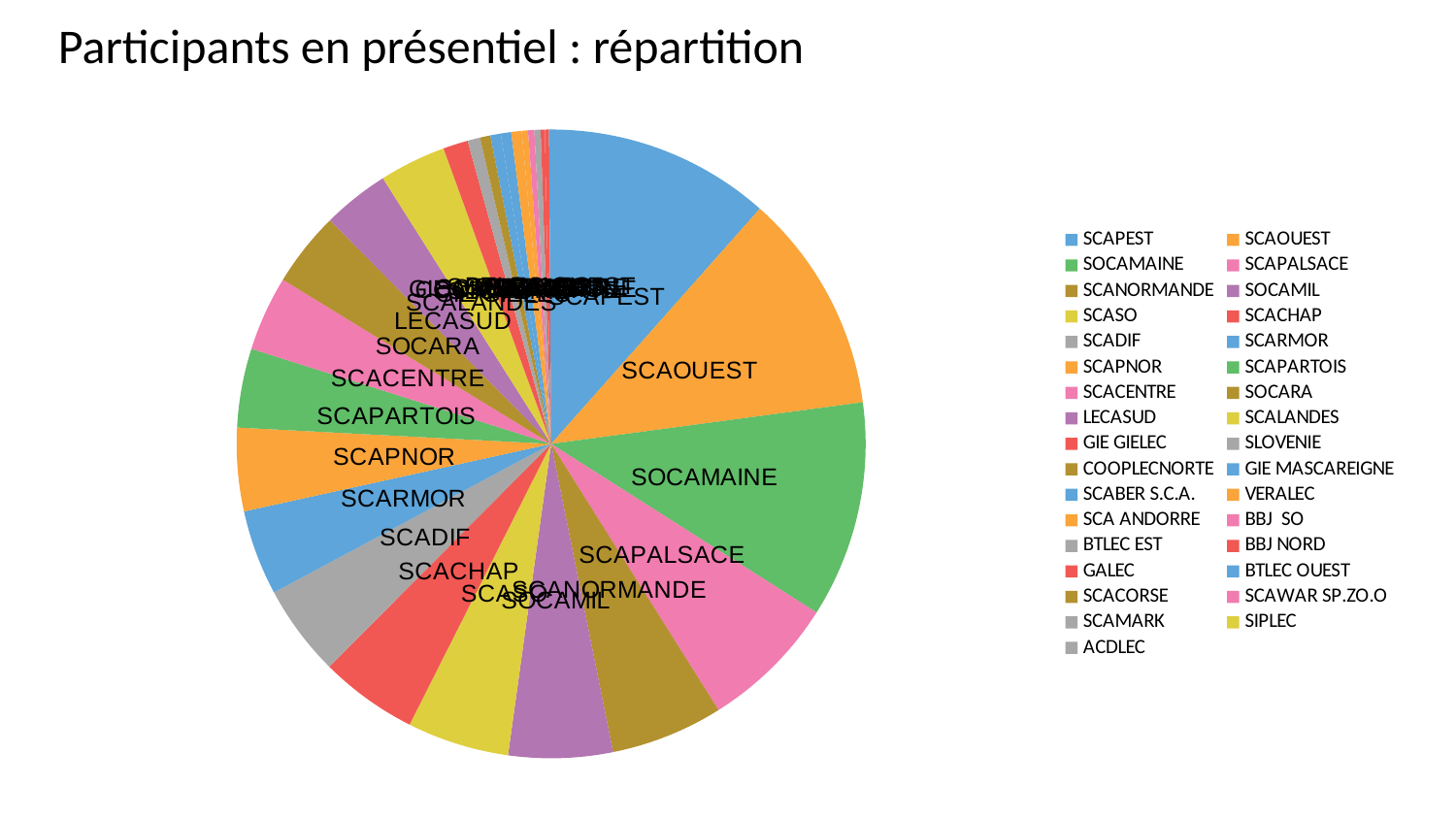
Which slice is larger, SCAPALSACE or SOCARA? SCAPALSACE How many entries does the chart's legend list? 33 What kind of chart is shown on the slide? pie chart Which slice is larger, SCAPEST or SCAPARTOIS? SCAPEST What colour is the SCAPEST slice in the legend? blue Which slice is larger, SCAOUEST or SCADIF? SCAOUEST What is the title of the chart on the slide? Participants en présentiel : répartition